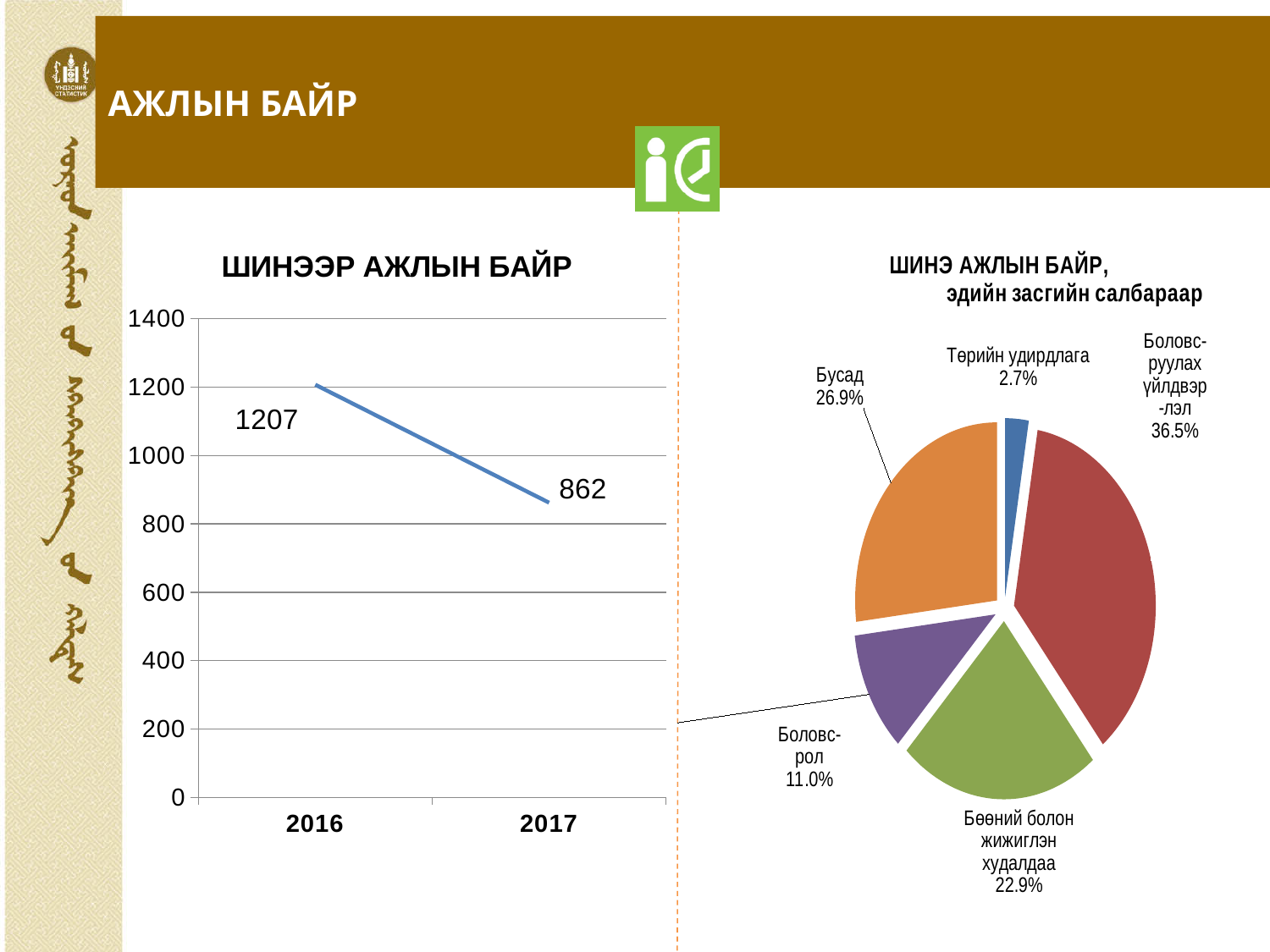
In the pie chart on the right, what share does "Бөөний болон жижиглэн худалдаа" have? 22.9% What kind of chart is the chart titled "ШИНЭЭР АЖЛЫН БАЙР"? line chart In the chart titled "ШИНЭЭР АЖЛЫН БАЙР", do the values rise or fall from 2016 to 2017? fall In the pie chart on the right, what share does "Боловсруулах үйлдвэрлэл" have? 36.5% In the pie chart on the right, which sector has the smallest share? Төрийн удирдлага In the chart titled "ШИНЭЭР АЖЛЫН БАЙР", what is the difference between the 2016 and 2017 values? 345 In the pie chart on the right, which sector has the largest share? Боловсруулах үйлдвэрлэл In the chart titled "ШИНЭЭР АЖЛЫН БАЙР", how many years are plotted? 2 In the chart titled "ШИНЭЭР АЖЛЫН БАЙР", what is the value for 2017? 862 In the pie chart on the right, how many slices are there? 5 What kind of chart is the chart titled "ШИНЭ АЖЛЫН БАЙР, эдийн засгийн салбараар"? pie chart In the chart titled "ШИНЭЭР АЖЛЫН БАЙР", what is the value for 2016? 1207